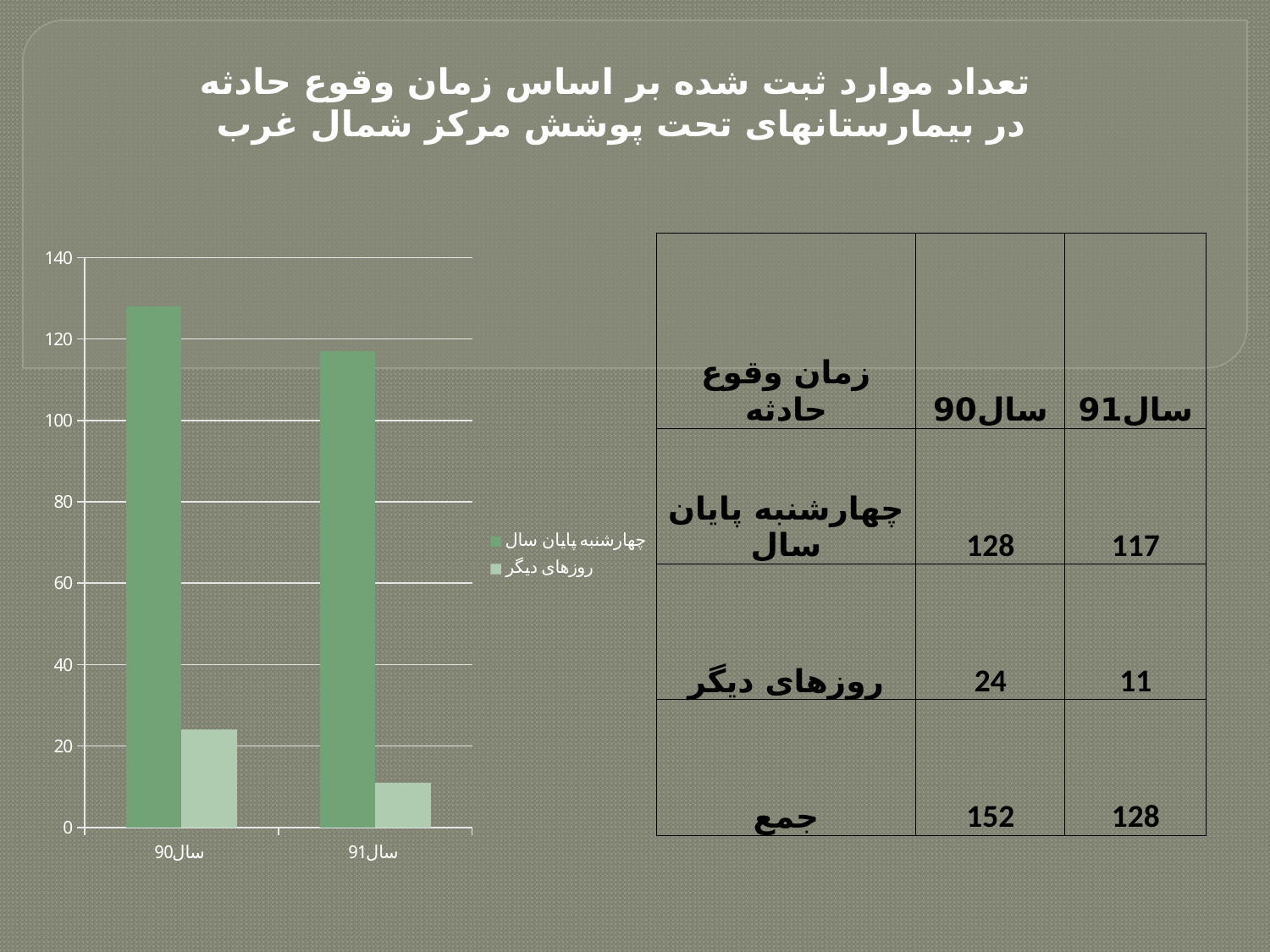
Do the چهارشنبه پایان سال values rise or fall from سال90 to سال91? fall Which year has the higher bar for چهارشنبه پایان سال? سال90 Which series is shown in the lighter green colour in the chart? روزهای دیگر What kind of chart is shown on the slide? bar chart What is the value for چهارشنبه پایان سال in سال90? 128 Which is larger, the روزهای دیگر value for سال90 or for سال91? سال90 Is the value for چهارشنبه پایان سال in سال91 greater or less than 100? greater How many series does the chart legend list? 2 How many categories are shown on the x axis of the chart? 2 What is the difference between the چهارشنبه پایان سال values for سال90 and سال91? 11 What is the value for روزهای دیگر in سال91? 11 Is the value for روزهای دیگر in سال90 greater or less than 40? less